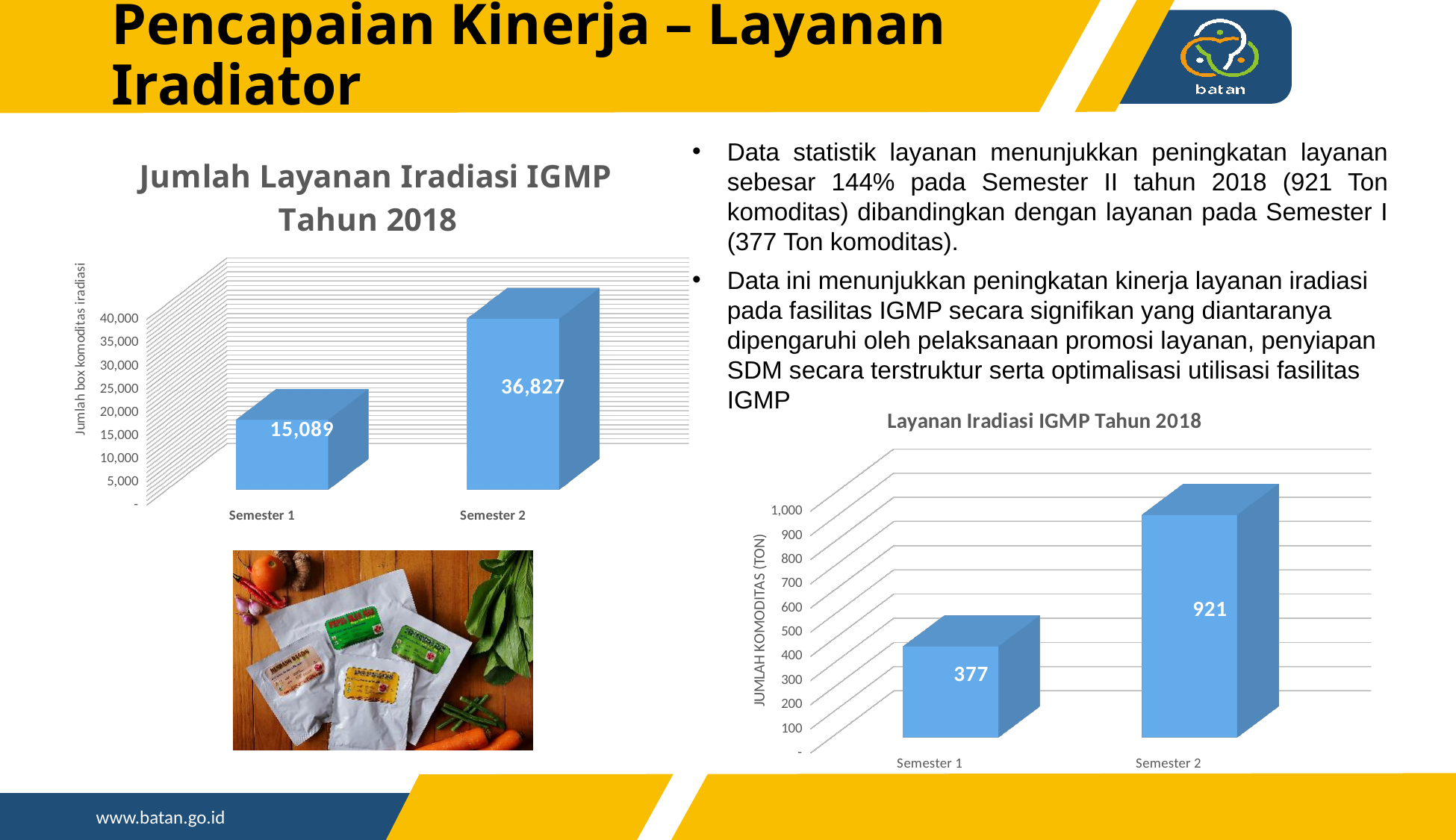
In the chart titled 'Jumlah Layanan Iradiasi IGMP Tahun 2018', which semester has the higher value? Semester 2 In the chart titled 'Jumlah Layanan Iradiasi IGMP Tahun 2018', how many categories are shown on the x axis? 2 In the chart titled 'Layanan Iradiasi IGMP Tahun 2018', which semester has the lower value? Semester 1 In the chart titled 'Jumlah Layanan Iradiasi IGMP Tahun 2018', what is the difference between Semester 2 and Semester 1? 21,738 In the chart titled 'Layanan Iradiasi IGMP Tahun 2018', what is the value for Semester 2? 921 In the chart titled 'Jumlah Layanan Iradiasi IGMP Tahun 2018', what is the y-axis label? Jumlah box komoditas iradiasi In the chart titled 'Layanan Iradiasi IGMP Tahun 2018', what is the difference between Semester 2 and Semester 1? 544 What kind of chart is the one titled 'Layanan Iradiasi IGMP Tahun 2018'? Bar chart In the chart titled 'Jumlah Layanan Iradiasi IGMP Tahun 2018', what is the value for Semester 2? 36,827 In the chart titled 'Layanan Iradiasi IGMP Tahun 2018', what is the value for Semester 1? 377 In the chart titled 'Layanan Iradiasi IGMP Tahun 2018', do the values rise or fall from Semester 1 to Semester 2? Rise In the chart titled 'Jumlah Layanan Iradiasi IGMP Tahun 2018', what is the value for Semester 1? 15,089